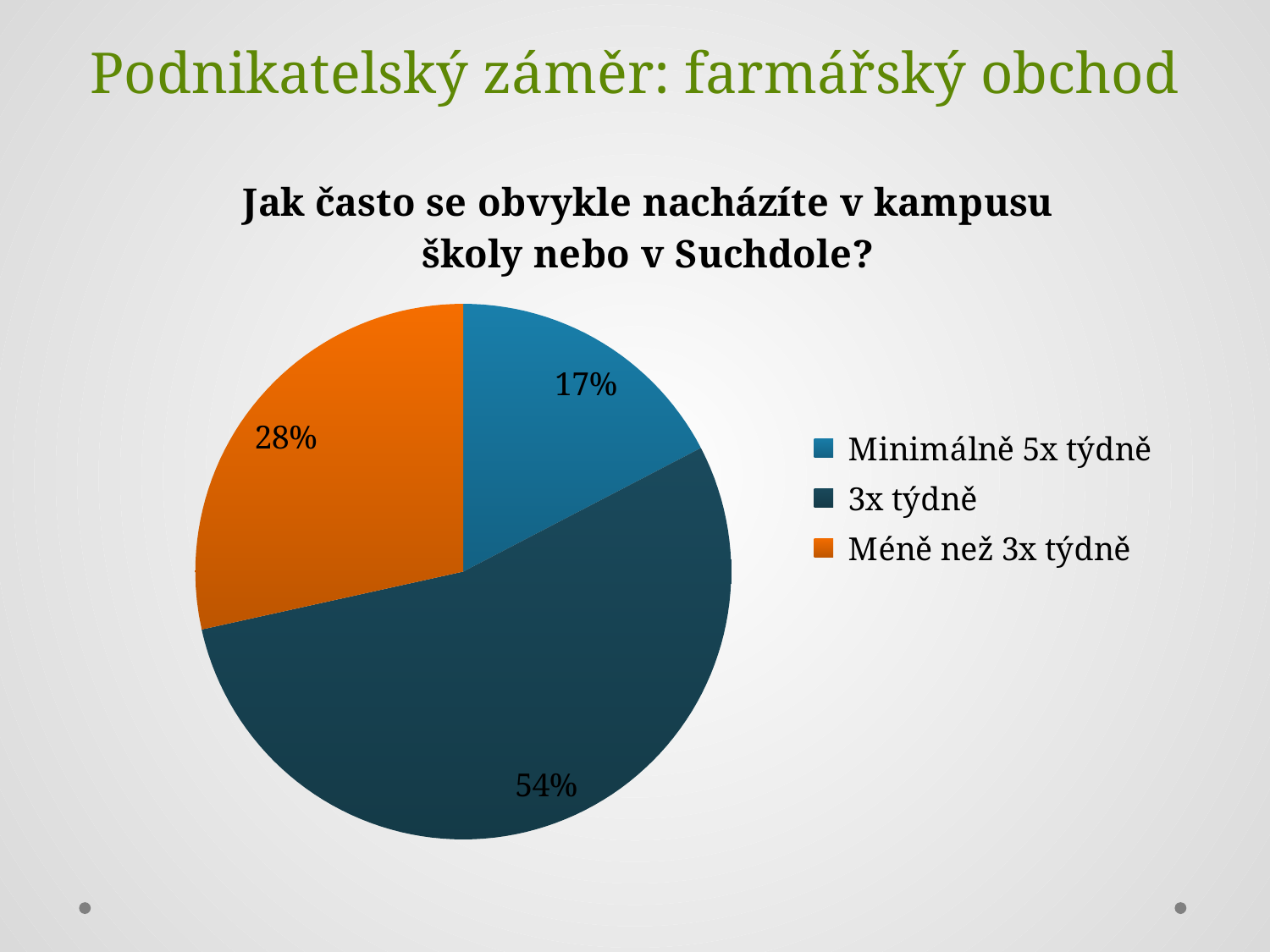
Which is larger: the slice for "Méně než 3x týdně" or the slice for "Minimálně 5x týdně"? Méně než 3x týdně Which colour represents "Méně než 3x týdně" in the chart? Orange What is the title of the chart? Jak často se obvykle nacházíte v kampusu školy nebo v Suchdole? How many slices does the pie chart have? 3 What is the difference in percentage points between "3x týdně" and "Méně než 3x týdně"? 26 What is the difference in percentage points between "Méně než 3x týdně" and "Minimálně 5x týdně"? 11 What kind of chart is shown on the slide? Pie chart Which category has the largest slice of the pie? 3x týdně What share of the pie does "3x týdně" represent? 54% What share of the pie does "Minimálně 5x týdně" represent? 17% Which category has the smallest slice of the pie? Minimálně 5x týdně What share of the pie does "Méně než 3x týdně" represent? 28%